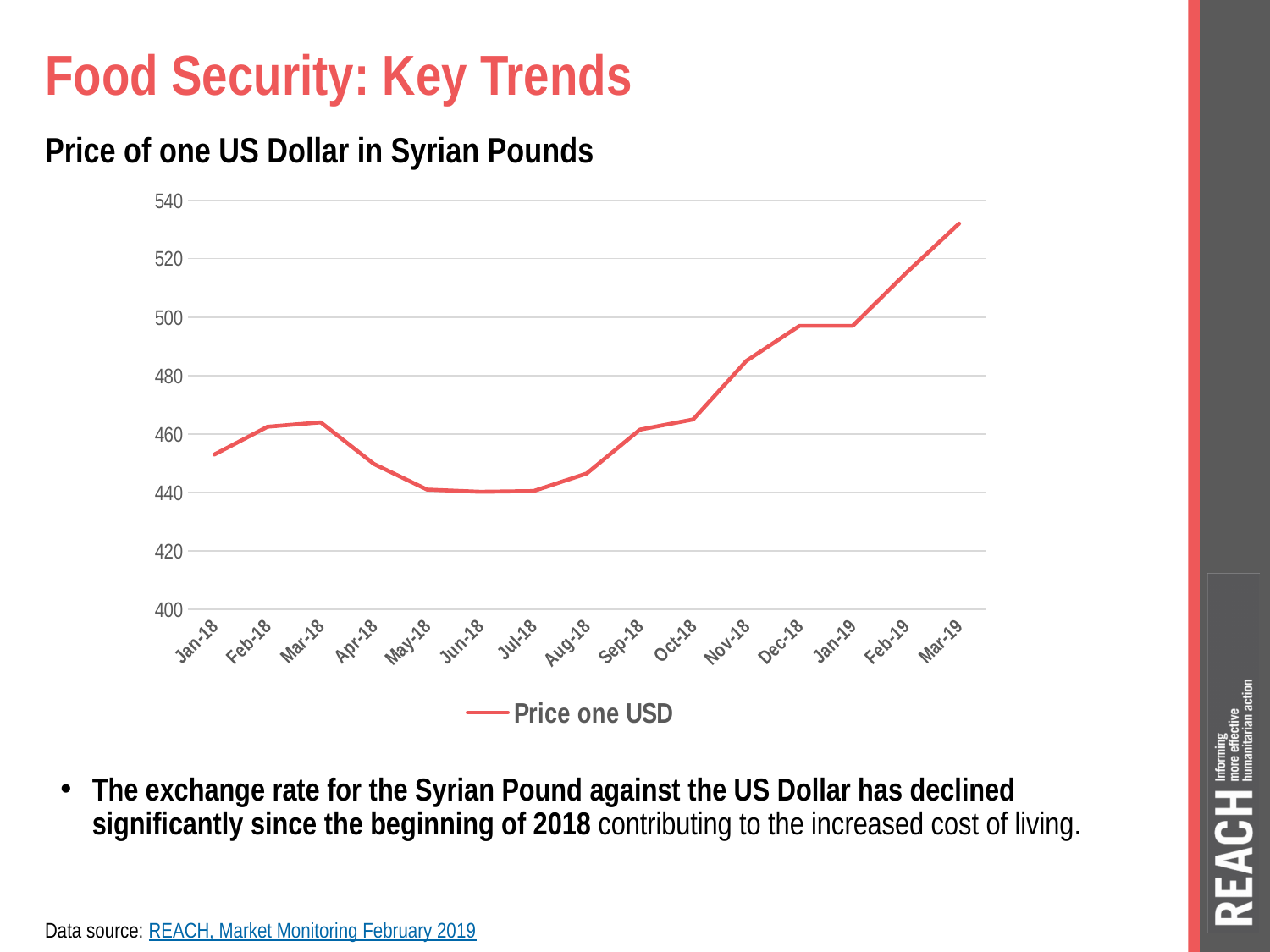
How many series does the legend list? 1 What kind of chart is shown on the slide? line chart Which is larger, the value for Mar-18 or the value for Jul-18? Mar-18 What colour is the plotted line? red Overall, does the price of one USD rise or fall from Jan-18 to Mar-19? rise What is the legend entry for the plotted line? Price one USD Is the value for Nov-18 greater or less than 470? greater How many months are plotted along the x axis? 15 Is the value for Mar-19 greater or less than 520? greater Is the value for May-18 greater or less than 460? less In which month is the price of one USD highest? Mar-19